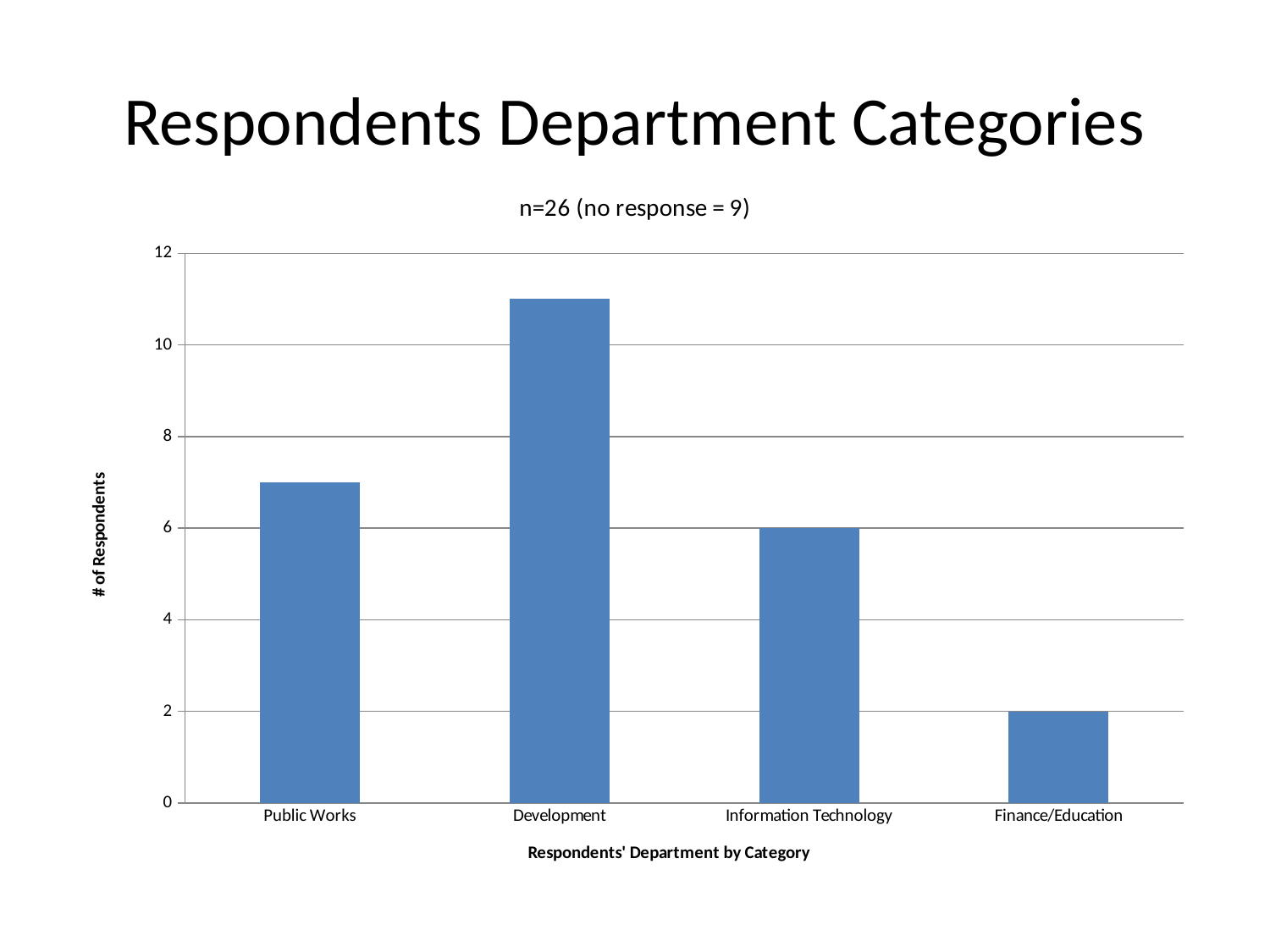
Which department category has the lowest number of respondents? Finance/Education How many respondents are in the Finance/Education category? 2 How many department categories are plotted on the chart? 4 Which has more respondents, Public Works or Information Technology? Public Works What is the title of the vertical axis? # of Respondents Is the value for Development greater or less than 10? greater What type of chart is shown on the slide? Bar chart Which department category has the highest number of respondents? Development Is the value for Public Works greater or less than 6? greater Is the value for Development greater or less than 12? less What is the difference in respondents between Information Technology and Finance/Education? 4 How many respondents are in the Information Technology category? 6